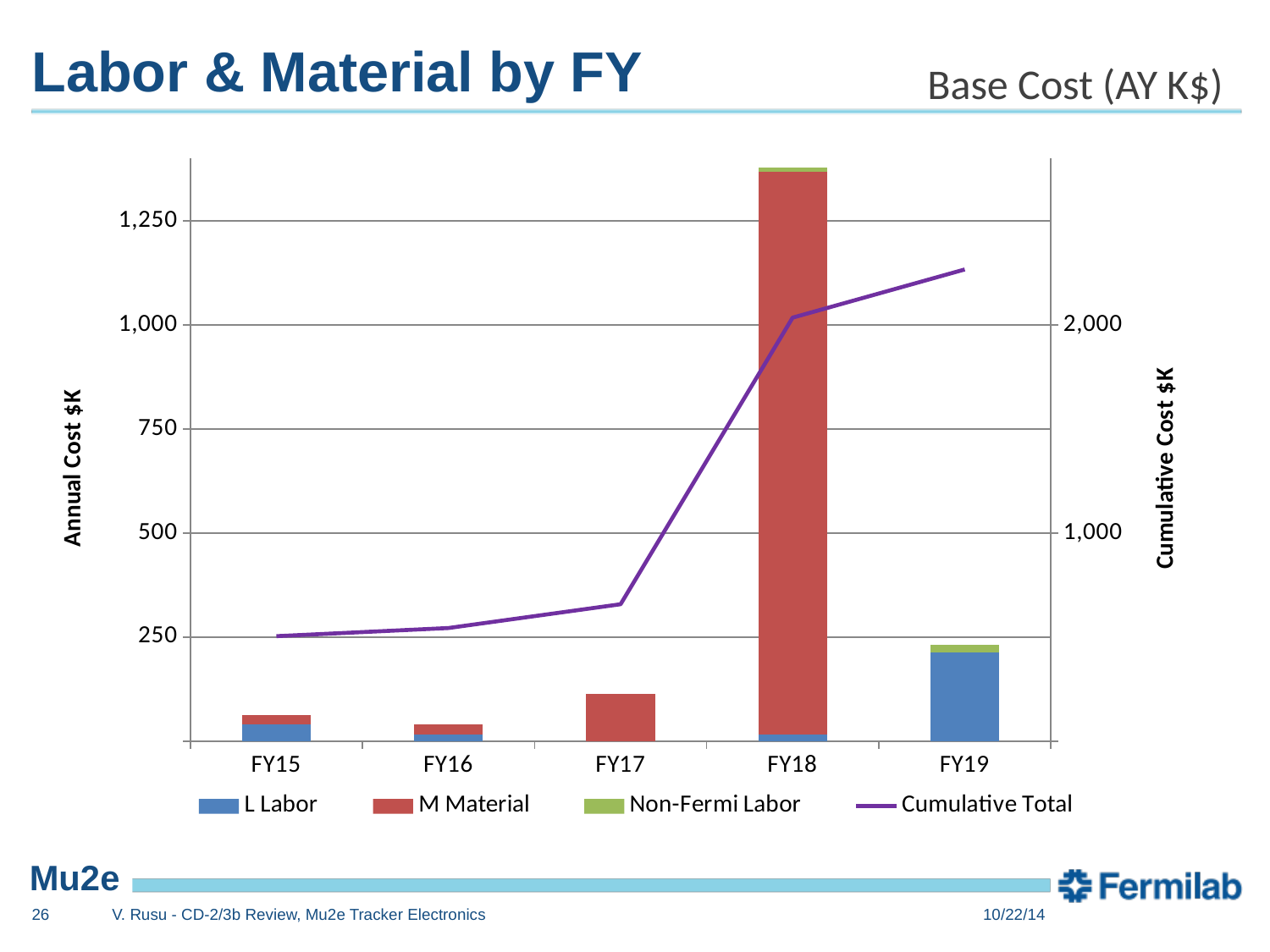
Which has the larger stacked bar, FY17 or FY15? FY17 How many series does the legend list? 4 What is the title of the right-hand vertical axis? Cumulative Cost $K What kind of chart is shown on the slide? Stacked bar chart with a line Does the Cumulative Total line rise or fall from FY15 to FY19? rises Is the total annual cost for FY18 greater or less than 1,250? greater Is the Cumulative Total for FY19 greater or less than 2,000 on the right axis? greater Which fiscal year has the shortest stacked bar? FY16 Which fiscal year has the tallest stacked bar? FY18 Which series is plotted as a line rather than bars? Cumulative Total How many fiscal years are shown on the x axis? 5 Is the total annual cost for FY19 greater or less than 500? less